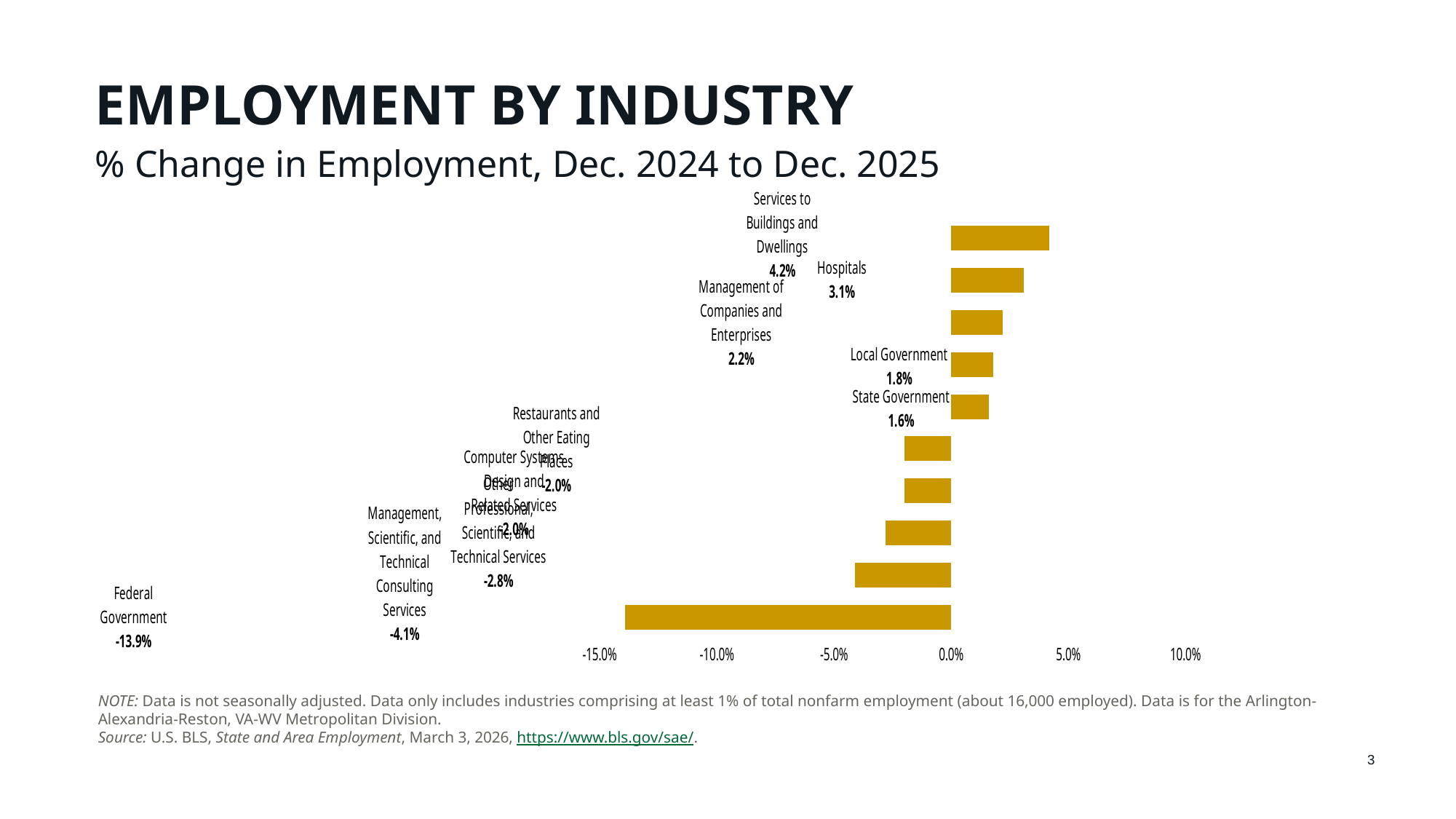
Which industry has the lowest % change in employment? Federal Government Which industry has the highest % change in employment? Services to Buildings and Dwellings What is the % change in employment for Services to Buildings and Dwellings? 4.2% How many industries (bars) are shown in the chart? 10 What is the difference in % change between Hospitals and Local Government? 1.3 percentage points What is the % change in employment for Federal Government? -13.9% Is the value for Federal Government greater or less than -10.0%? less What kind of chart is shown on the slide? Bar chart What is the % change in employment for Hospitals? 3.1% What time period does the chart's subtitle say the % change in employment covers? Dec. 2024 to Dec. 2025 What is the % change in employment for Management of Companies and Enterprises? 2.2% Which has a larger % change in employment, Local Government or State Government? Local Government